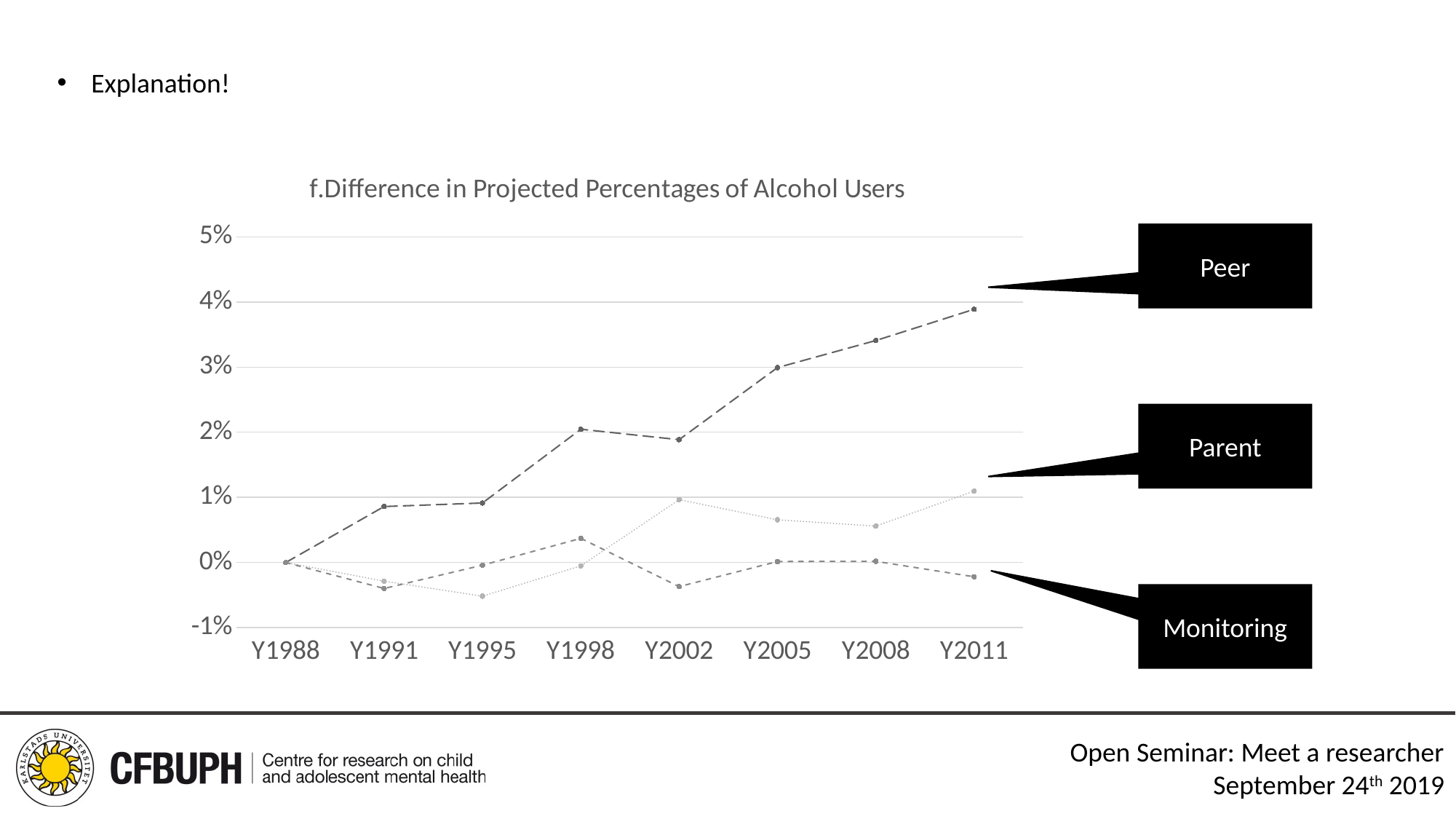
Is the value for Peer at Y2011 greater or less than 3%? greater Which series has the highest value at Y2011? Peer What is the title of the chart? f.Difference in Projected Percentages of Alcohol Users Is the value for Peer at Y2011 greater or less than 4%? less How many series are labelled on the chart? 3 How many years are shown along the x axis of the chart? 8 Is the value for Peer at Y1998 greater or less than 1%? greater Which series has the lowest value at Y2011? Monitoring At Y2005, which is larger: the Peer value or the Monitoring value? Peer Does the Peer series rise or fall from Y1988 to Y2011? rise What kind of chart is shown on the slide? line chart